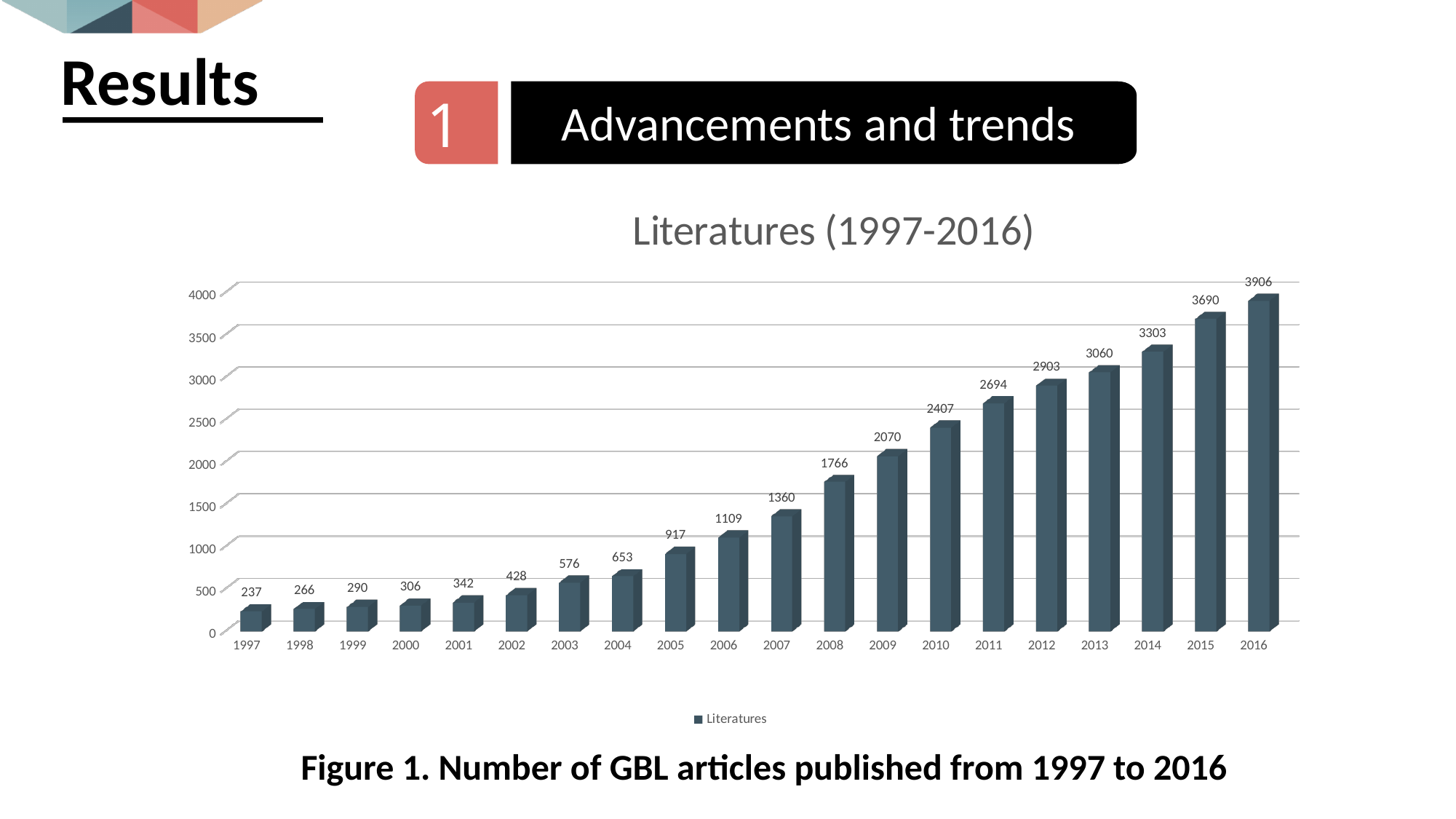
Which year has the highest value? 2016 What is the difference between the values for 2008 and 2007? 406 What is the value for 1997? 237 Do the values rise or fall from 1997 to 2016? rise What is the value for 2005? 917 Which year has the lowest value? 1997 What is the difference between the values for 2016 and 2015? 216 How many years are shown on the x axis? 20 What kind of chart is shown? bar chart Is the value for 2013 greater or less than 3000? greater What is the value for 2012? 2903 Which is larger, the value for 2009 or the value for 2006? 2009